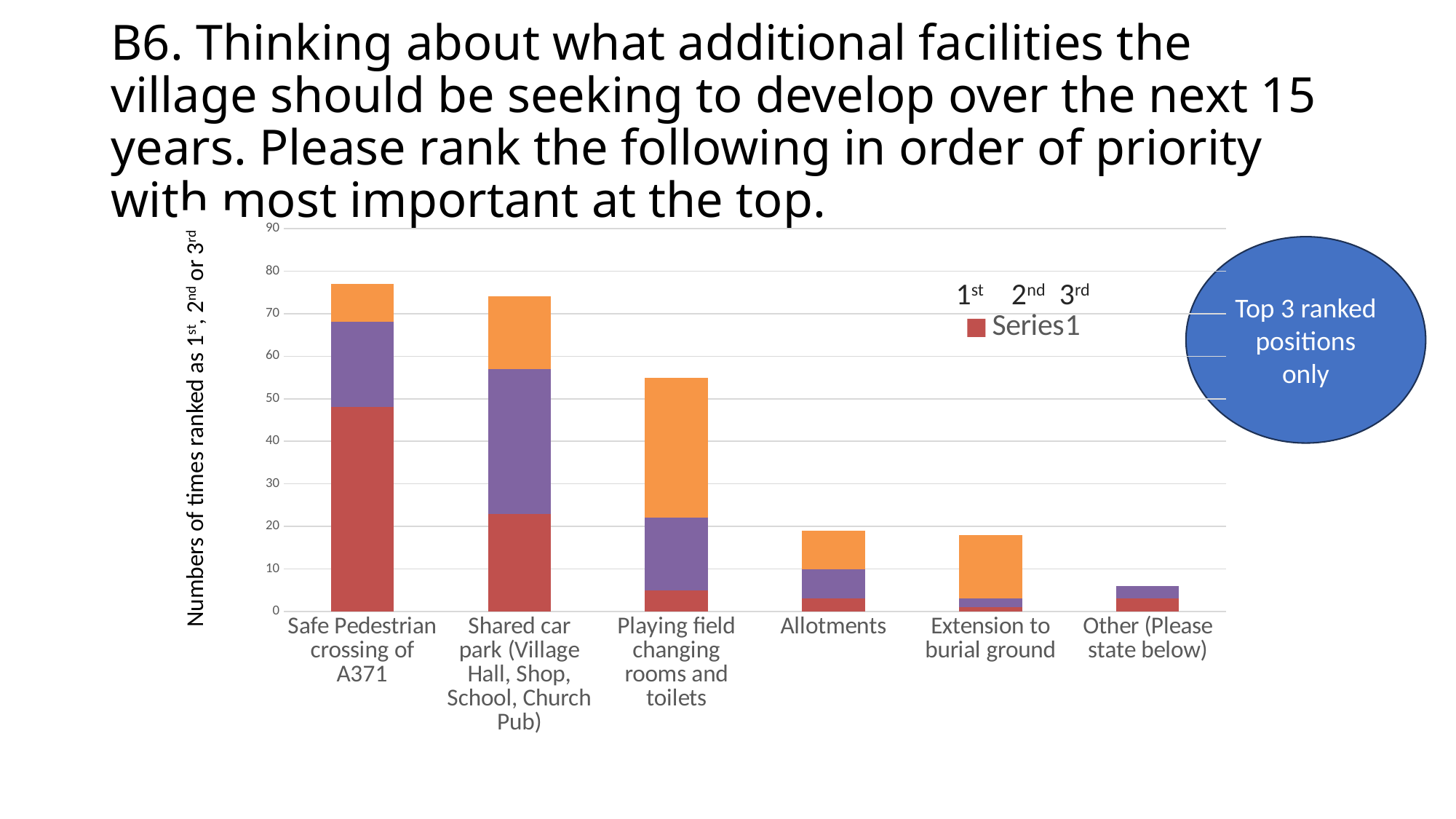
What kind of chart is shown on the slide? stacked bar chart Which category has the tallest bar in the chart? Safe Pedestrian crossing of A371 Is the total bar height for Safe Pedestrian crossing of A371 greater or less than 70? greater What is the title of the vertical axis of the chart? Numbers of times ranked as 1st, 2nd or 3rd Is the total bar height for Playing field changing rooms and toilets greater or less than 50? greater What colour is the bottom segment of each stacked bar? red How many categories are shown on the x axis of the chart? 6 Do the bar totals generally rise or fall moving from left to right along the x axis? fall Is the total bar height for Other (Please state below) greater or less than 10? less Which category has the shortest bar in the chart? Other (Please state below) Which has the taller bar: Playing field changing rooms and toilets or Allotments? Playing field changing rooms and toilets